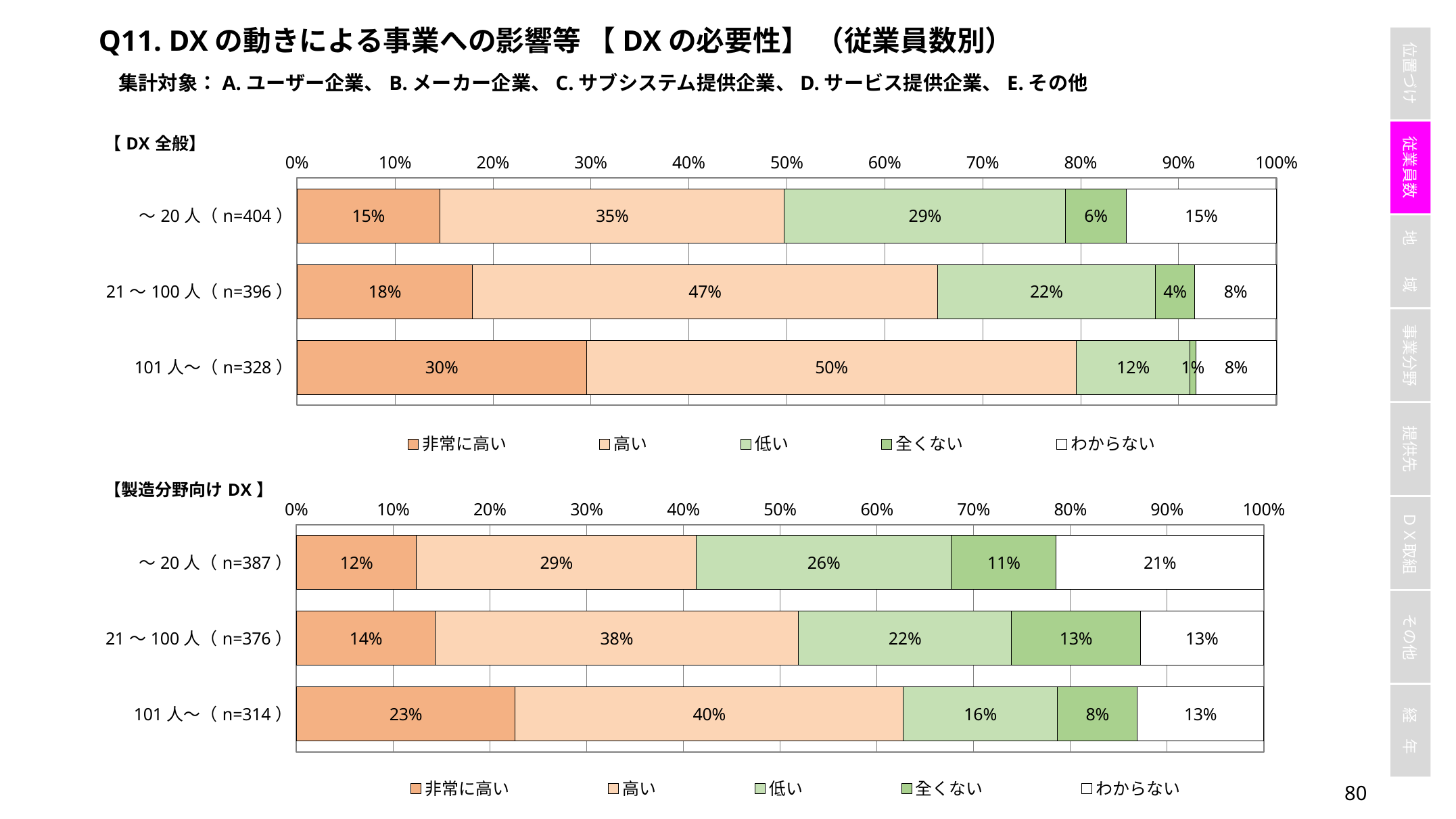
In the 【DX 全般】 chart, what is the value of 非常に高い for 〜20 人 (n=404)? 15% In the 【製造分野向け DX】 chart, what is the value of 全くない for 21〜100 人 (n=376)? 13% In the 【DX 全般】 chart, what is the difference between the 高い values for 101 人〜 (n=328) and 〜20 人 (n=404)? 15% In the 【製造分野向け DX】 chart, what is the value of わからない for 〜20 人 (n=387)? 21% How many series does the legend of the 【DX 全般】 chart list? 5 What kind of chart is the 【DX 全般】 chart? Stacked bar chart In the 【DX 全般】 chart, which category has the highest value for 非常に高い? 101 人〜 (n=328) In the 【製造分野向け DX】 chart, what is the combined value of 非常に高い and 高い for 101 人〜 (n=314)? 63% In the 【製造分野向け DX】 chart, which category has the lowest value for 全くない? 101 人〜 (n=314) How many categories are shown in the 【製造分野向け DX】 chart? 3 In the 【製造分野向け DX】 chart, which is larger: 低い for 〜20 人 (n=387) or 低い for 101 人〜 (n=314)? 〜20 人 (n=387) In the 【DX 全般】 chart, what is the value of 高い for 101 人〜 (n=328)? 50%